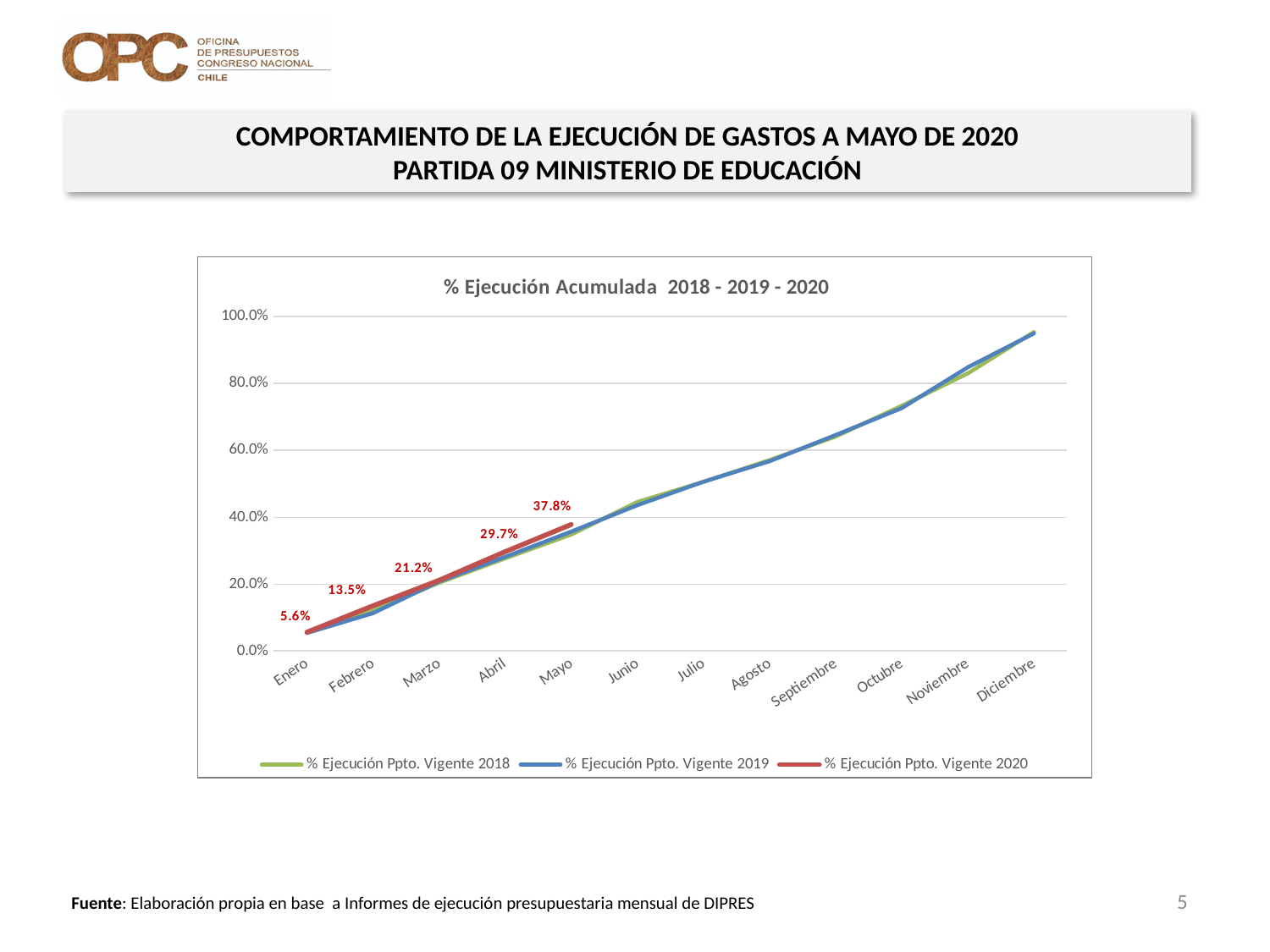
Do the values in the % Ejecución Ppto. Vigente 2019 series rise or fall from Enero to Diciembre? Rise What is the value for Enero in the % Ejecución Ppto. Vigente 2020 series? 5.6% How many months are shown on the x axis? 12 Is the value for Diciembre in the % Ejecución Ppto. Vigente 2019 series greater or less than 80.0%? greater Which month has the highest value in the % Ejecución Ppto. Vigente 2020 series? Mayo What kind of chart is shown on the slide? Line chart What is the value for Marzo in the % Ejecución Ppto. Vigente 2020 series? 21.2% How many series does the legend list? 3 What is the value for Mayo in the % Ejecución Ppto. Vigente 2020 series? 37.8% What is the difference between the Mayo and Enero values in the % Ejecución Ppto. Vigente 2020 series? 32.2% What is the title of the chart? % Ejecución Acumulada 2018 - 2019 - 2020 What is the difference between the Abril and Marzo values in the % Ejecución Ppto. Vigente 2020 series? 8.5%